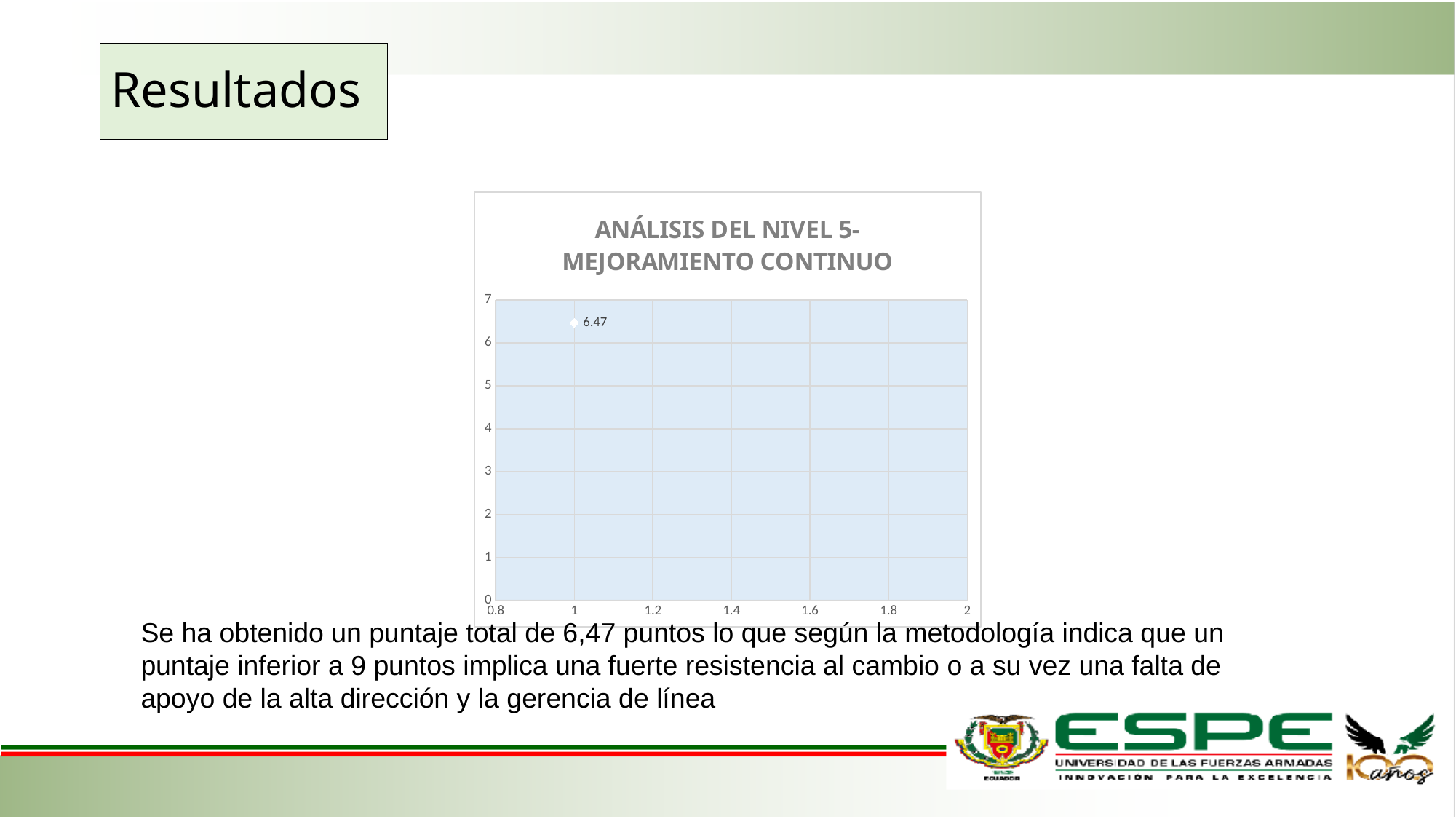
Is the value of the plotted point greater or less than 7? less What is the highest value shown on the chart's vertical axis? 7 At which x-axis tick is the plotted point located? 1 What is the title of the chart? ANÁLISIS DEL NIVEL 5- MEJORAMIENTO CONTINUO What kind of chart is shown on the slide? scatter chart Is the value of the plotted point greater or less than 6? greater How many data points are plotted in the chart? 1 What is the value shown by the data label on the single point in the chart? 6.47